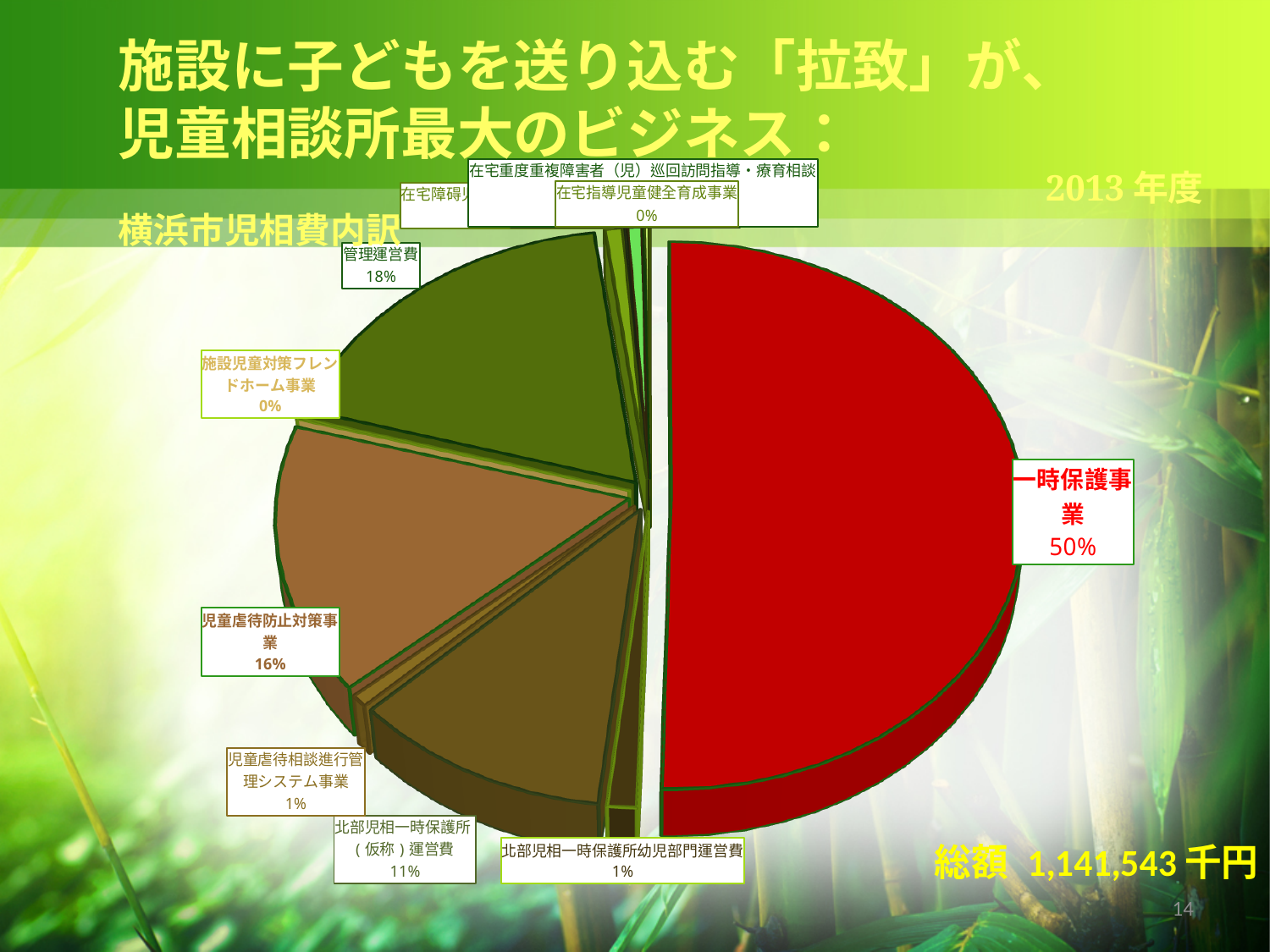
What percentage is shown for 施設児童対策フレンドホーム事業? 0% What total amount (総額) is stated on the slide? 1,141,543 千円 What percentage is shown for 児童虐待相談進行管理システム事業? 1% Which is larger, the share for 管理運営費 or the share for 児童虐待防止対策事業? 管理運営費 Which category has the largest share of the pie? 一時保護事業 What percentage is shown for 児童虐待防止対策事業? 16% What percentage is shown for 管理運営費? 18% What percentage is shown for 北部児相一時保護所（仮称）運営費? 11% What kind of chart is shown on the slide? pie chart What share of the pie does 一時保護事業 account for? 50% By how many percentage points does the share of 一時保護事業 exceed that of 管理運営費? 32 percentage points Which fiscal year does the chart cover? 2013 年度